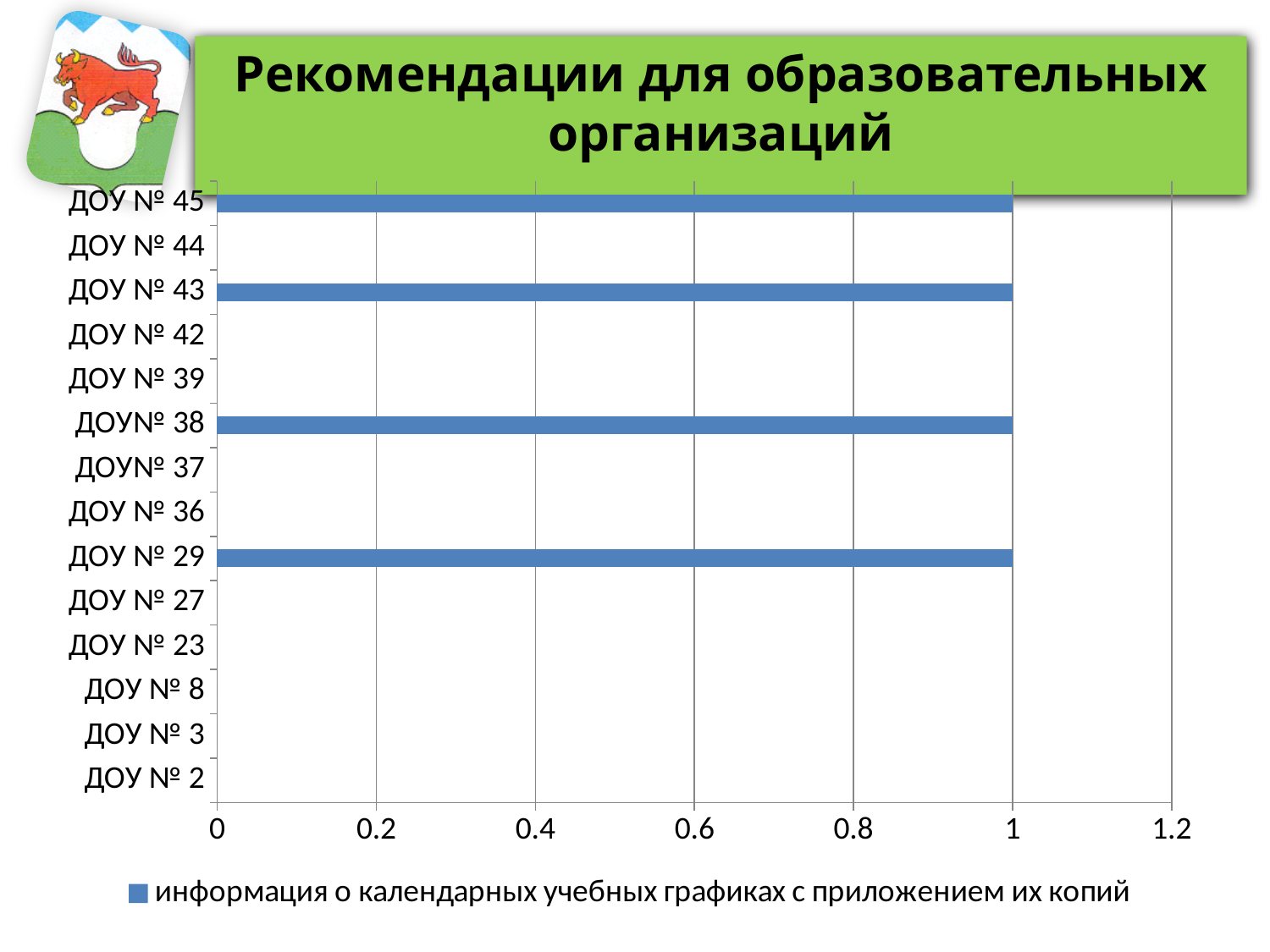
Which is larger, the value for ДОУ № 29 or the value for ДОУ № 27? ДОУ № 29 What is the title shown above the chart? Рекомендации для образовательных организаций What kind of chart is shown on the slide? bar chart What is the value for ДОУ № 43? 1 How many categories are listed on the vertical axis of the chart? 14 Is the value for ДОУ № 38 greater or less than 0.8? greater How many categories have a visible bar in the chart? 4 What is the value for ДОУ № 29? 1 What is the name of the series shown in the chart legend? информация о календарных учебных графиках с приложением их копий Which is larger, the value for ДОУ № 43 or the value for ДОУ № 42? ДОУ № 43 What is the value for ДОУ № 45? 1 How many series does the chart legend list? 1